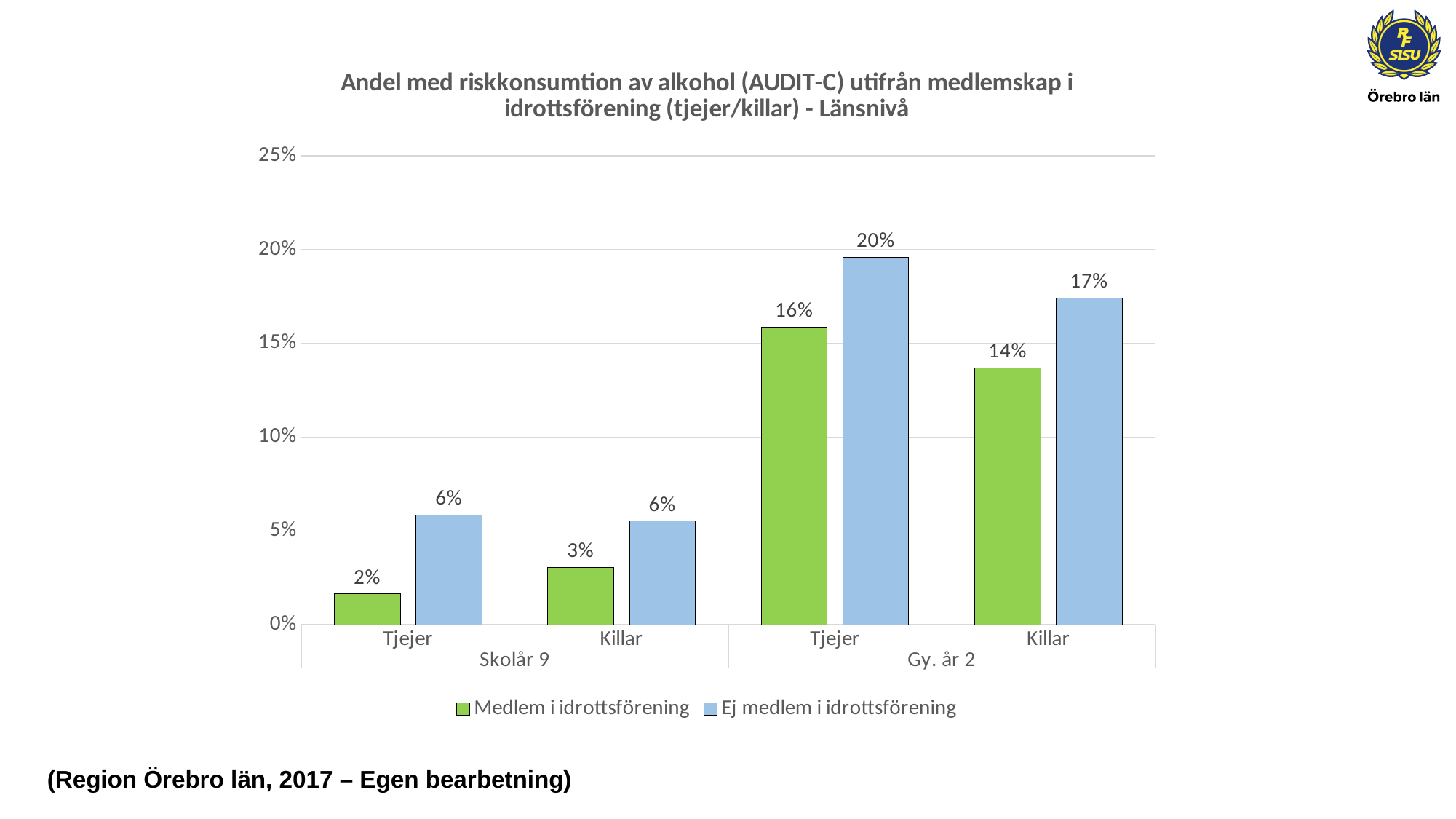
Which colour represents Medlem i idrottsförening in the chart? Green What is the value for Medlem i idrottsförening for Killar in Gy. år 2? 14% Is the value for Ej medlem i idrottsförening for Killar in Gy. år 2 greater or less than 15%? greater What is the value for Medlem i idrottsförening for Tjejer in Skolår 9? 2% What kind of chart is shown on the slide? Bar chart Which bar has the lowest value in the chart? Medlem i idrottsförening, Tjejer, Skolår 9 (2%) What is the difference between Ej medlem i idrottsförening and Medlem i idrottsförening for Tjejer in Gy. år 2? 4% Which bar has the highest value in the chart? Ej medlem i idrottsförening, Tjejer, Gy. år 2 (20%) What is the value for Ej medlem i idrottsförening for Tjejer in Gy. år 2? 20% What is the value for Ej medlem i idrottsförening for Killar in Skolår 9? 6% For Medlem i idrottsförening in Gy. år 2, which is larger: Tjejer or Killar? Tjejer How many series does the legend list? 2